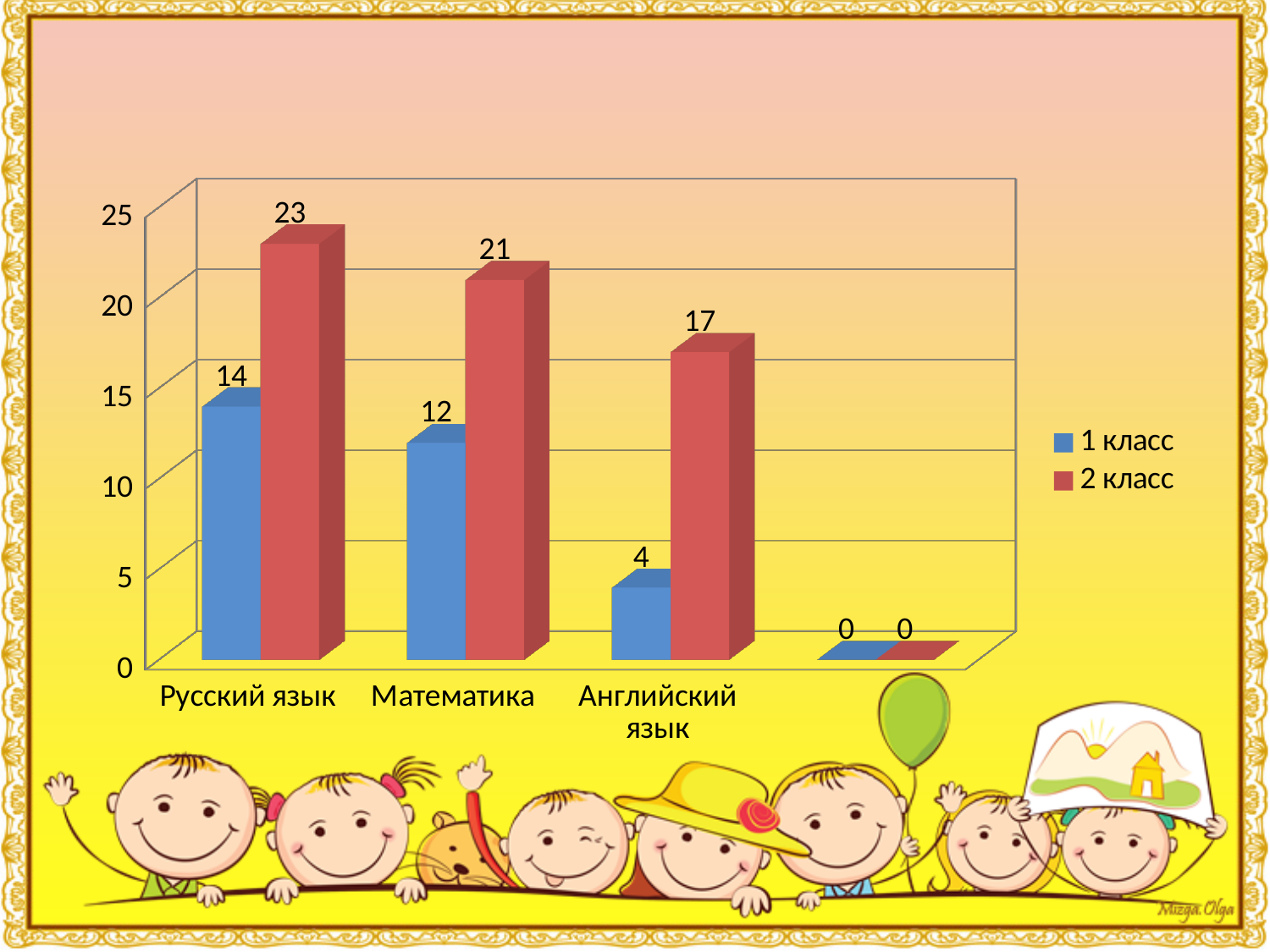
Which is larger in Математика: 1 класс or 2 класс? 2 класс Which labeled subject has the lowest value for 1 класс? Английский язык What is the value for 1 класс in Английский язык? 4 What is the value for 2 класс in Английский язык? 17 What is the value for 2 класс in Математика? 21 What is the value for 1 класс in Русский язык? 14 What is the difference between 2 класс and 1 класс in Английский язык? 13 Which colour represents 2 класс in the legend? Red What is the difference between 2 класс and 1 класс in Русский язык? 9 What kind of chart is shown on the slide? Bar chart How many series does the legend list? 2 Which labeled subject has the highest value for 2 класс? Русский язык